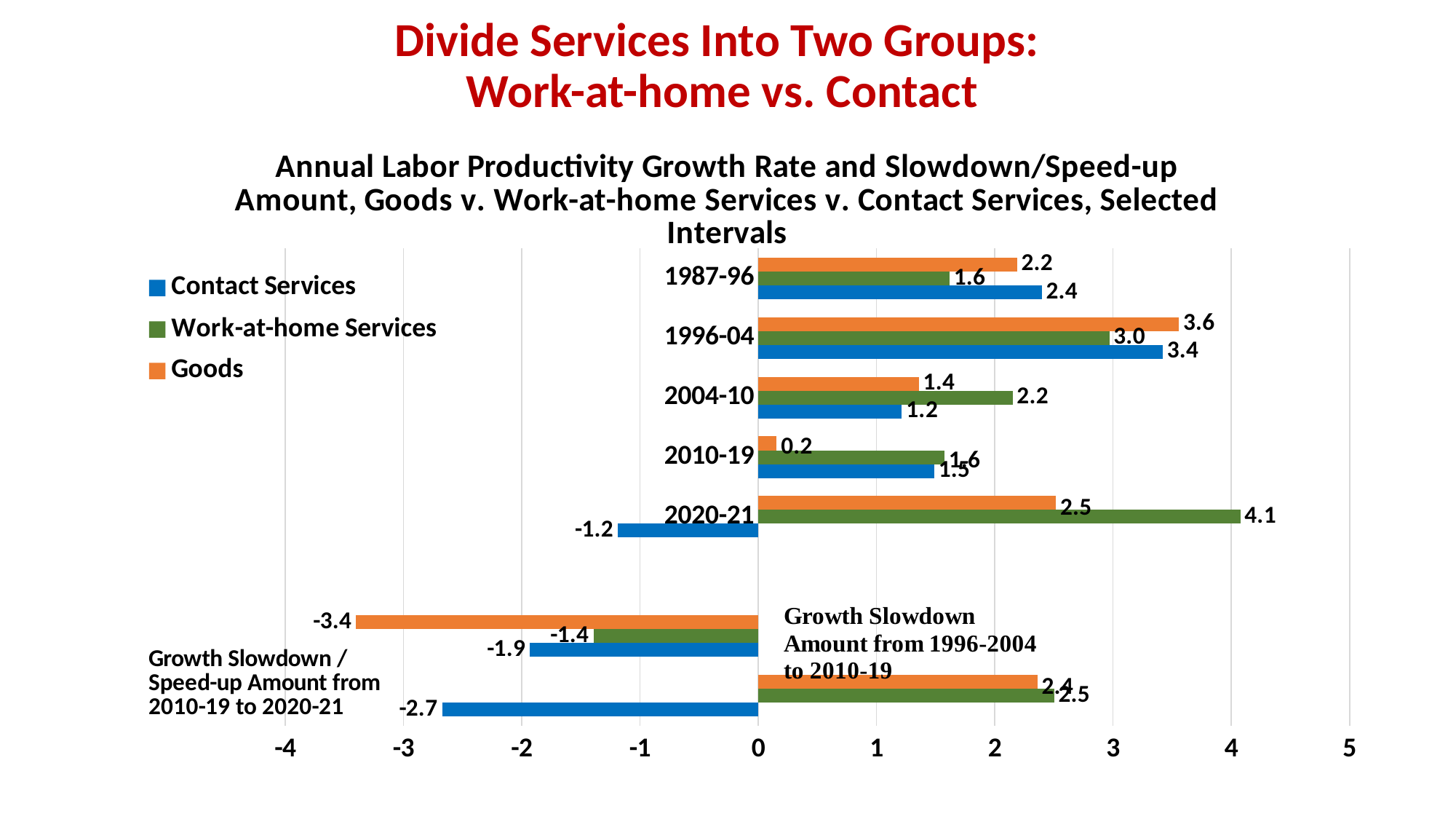
Among the five time intervals (1987-96 through 2020-21), which has the highest Goods value? 1996-04 What is the Contact Services value for 2020-21? -1.2 What is the lowest Contact Services value shown on the chart? -2.7 How many series does the legend list? 3 What is the Goods value for 2010-19? 0.2 What is the Work-at-home Services value for 2020-21? 4.1 What is the Goods value for the Growth Slowdown Amount from 1996-2004 to 2010-19? -3.4 What is the difference between the Goods and Work-at-home Services values for 1996-04? 0.6 For 2004-10, which is larger: Work-at-home Services or Goods? Work-at-home Services What is the Goods value for 1996-04? 3.6 What colour represents Goods in the legend? orange What kind of chart is shown on the slide? bar chart